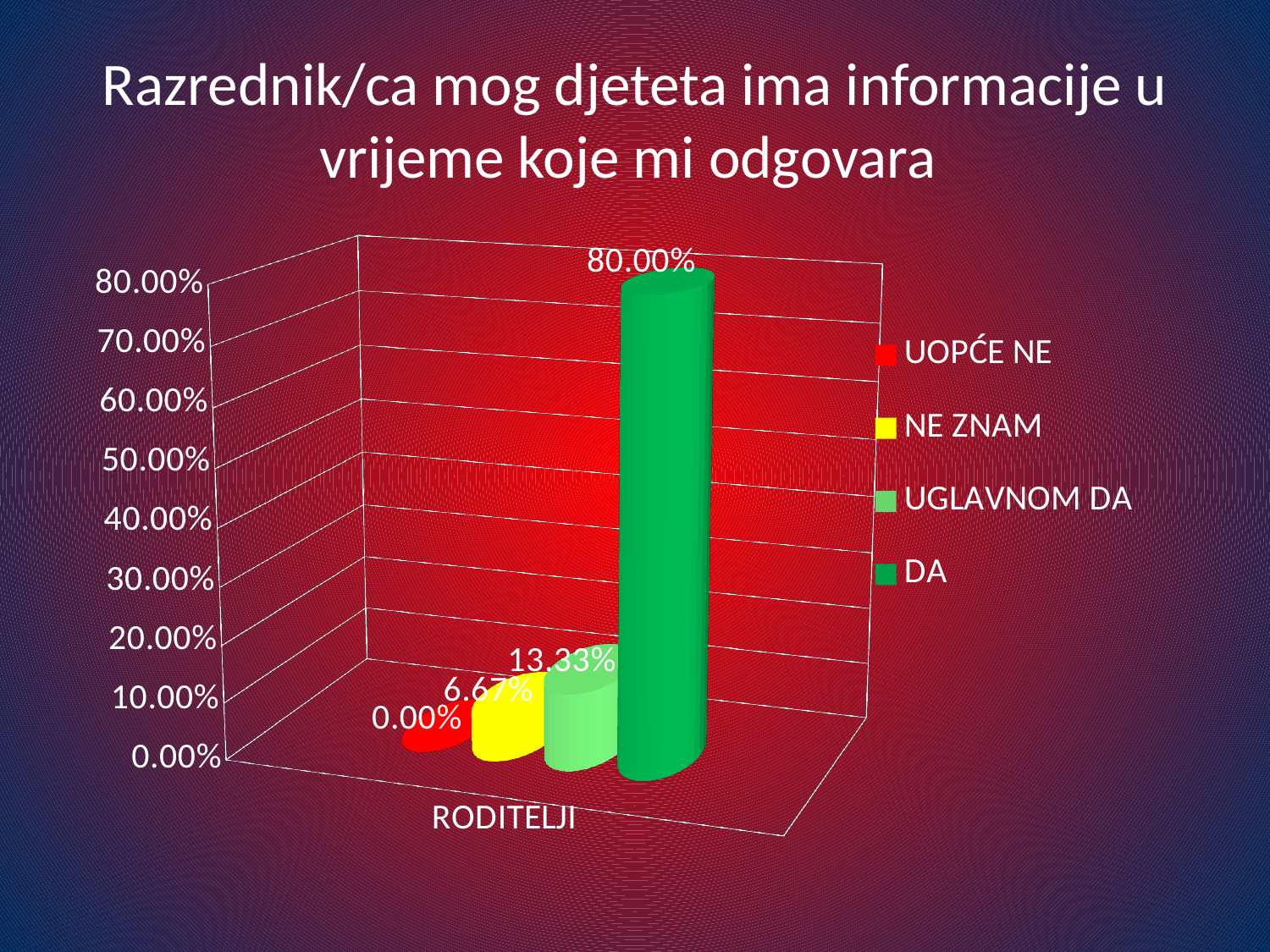
What is the value for UOPĆE NE? 0.00% How many series does the legend list? 4 What is the value for DA? 80.00% What is the difference between the values for DA and UGLAVNOM DA? 66.67% Which is larger, the value for UGLAVNOM DA or the value for NE ZNAM? UGLAVNOM DA What is the category label on the x axis? RODITELJI What is the value for NE ZNAM? 6.67% Which series has the lowest value? UOPĆE NE What colour is the bar for DA? Green What is the value for UGLAVNOM DA? 13.33% Which series has the highest value? DA What kind of chart is shown on the slide? Bar chart